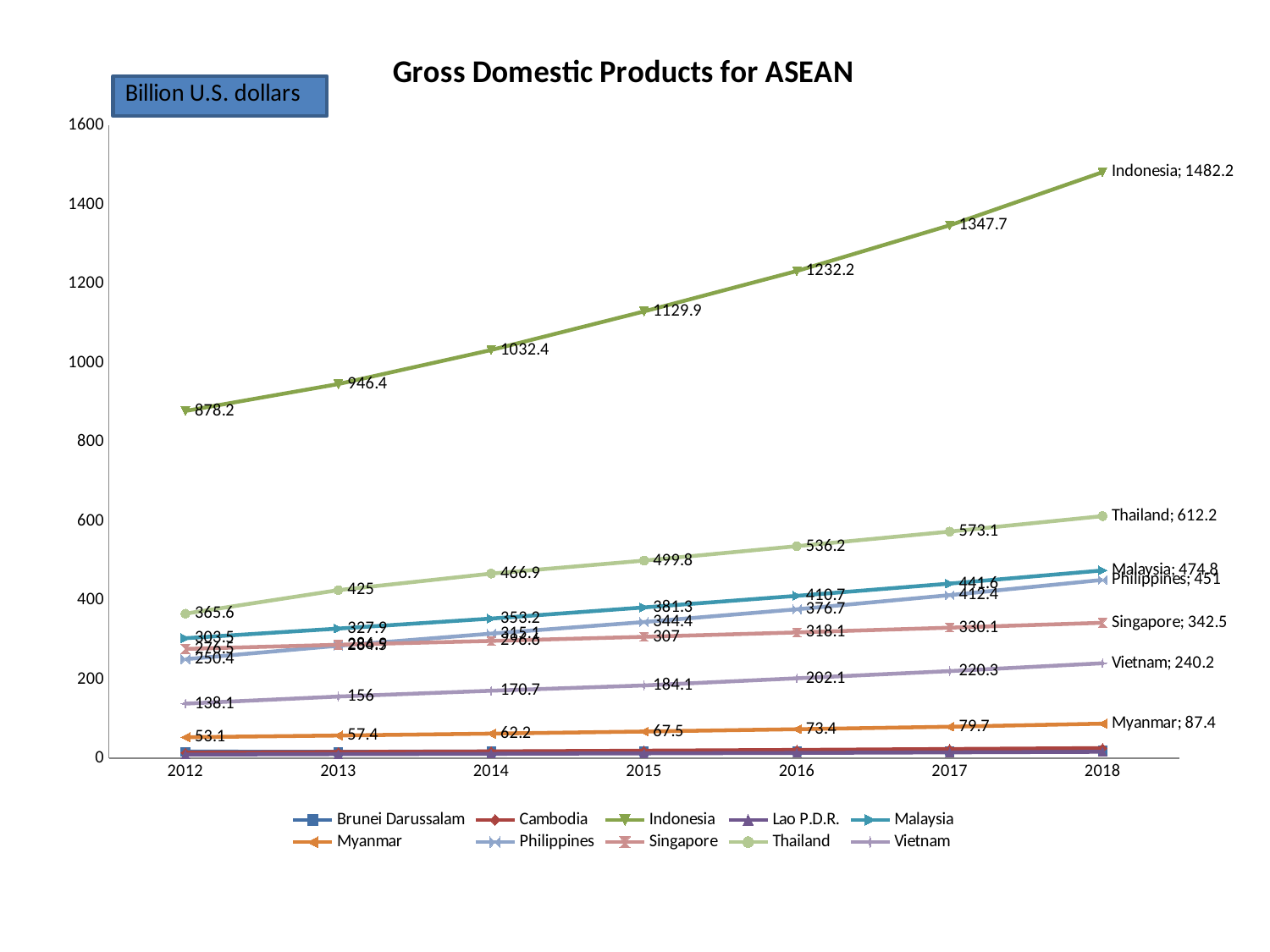
What is the value for Indonesia in 2018? 1482.2 How many series does the legend list? 10 What is the value for Vietnam in 2015? 184.1 How many years are shown on the x axis? 7 Is the value for Brunei Darussalam in 2018 greater or less than 200? less By how much did Indonesia's value increase from 2012 to 2018? 604 Which country has the highest value in 2018? Indonesia What is the value for Myanmar in 2018? 87.4 Does the value for Indonesia rise or fall from 2012 to 2018? rise What is the value for Thailand in 2012? 365.6 In 2016, which is larger: the value for Malaysia or the value for Singapore? Malaysia What kind of chart is this? line chart